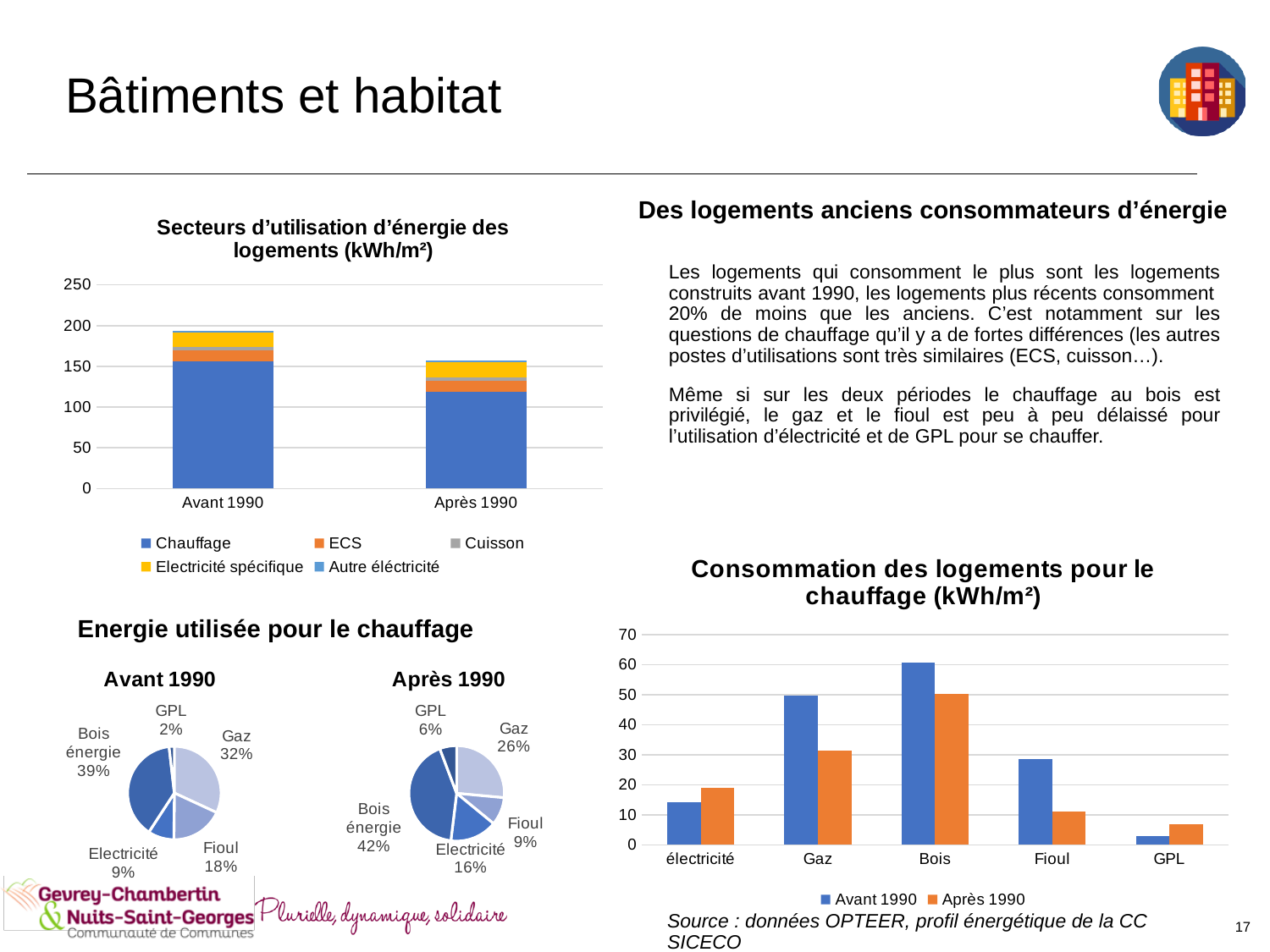
In the 'Avant 1990' pie chart under 'Energie utilisée pour le chauffage', which energy source has the smallest share? GPL In the 'Consommation des logements pour le chauffage (kWh/m²)' chart, which energy source has the highest value for Avant 1990? Bois In the 'Secteurs d'utilisation d'énergie des logements (kWh/m²)' chart, is the total for Avant 1990 greater or less than 150? greater In the 'Energie utilisée pour le chauffage' pie charts, what is the difference between the Fioul share before 1990 and after 1990? 9% In the 'Energie utilisée pour le chauffage' pie charts, how many energy sources are shown in each pie? 5 In the 'Après 1990' pie chart under 'Energie utilisée pour le chauffage', which energy source has the largest share? Bois énergie What kind of chart is 'Secteurs d'utilisation d'énergie des logements (kWh/m²)'? Stacked bar chart In the 'Consommation des logements pour le chauffage (kWh/m²)' chart, is the Avant 1990 value for Gaz greater or less than 40? greater In the 'Avant 1990' pie chart under 'Energie utilisée pour le chauffage', what share does Bois énergie have? 39% In the 'Après 1990' pie chart under 'Energie utilisée pour le chauffage', what share does Gaz have? 26% In the 'Consommation des logements pour le chauffage (kWh/m²)' chart, which is larger for électricité: Avant 1990 or Après 1990? Après 1990 How many series does the legend of the 'Consommation des logements pour le chauffage (kWh/m²)' chart list? 2